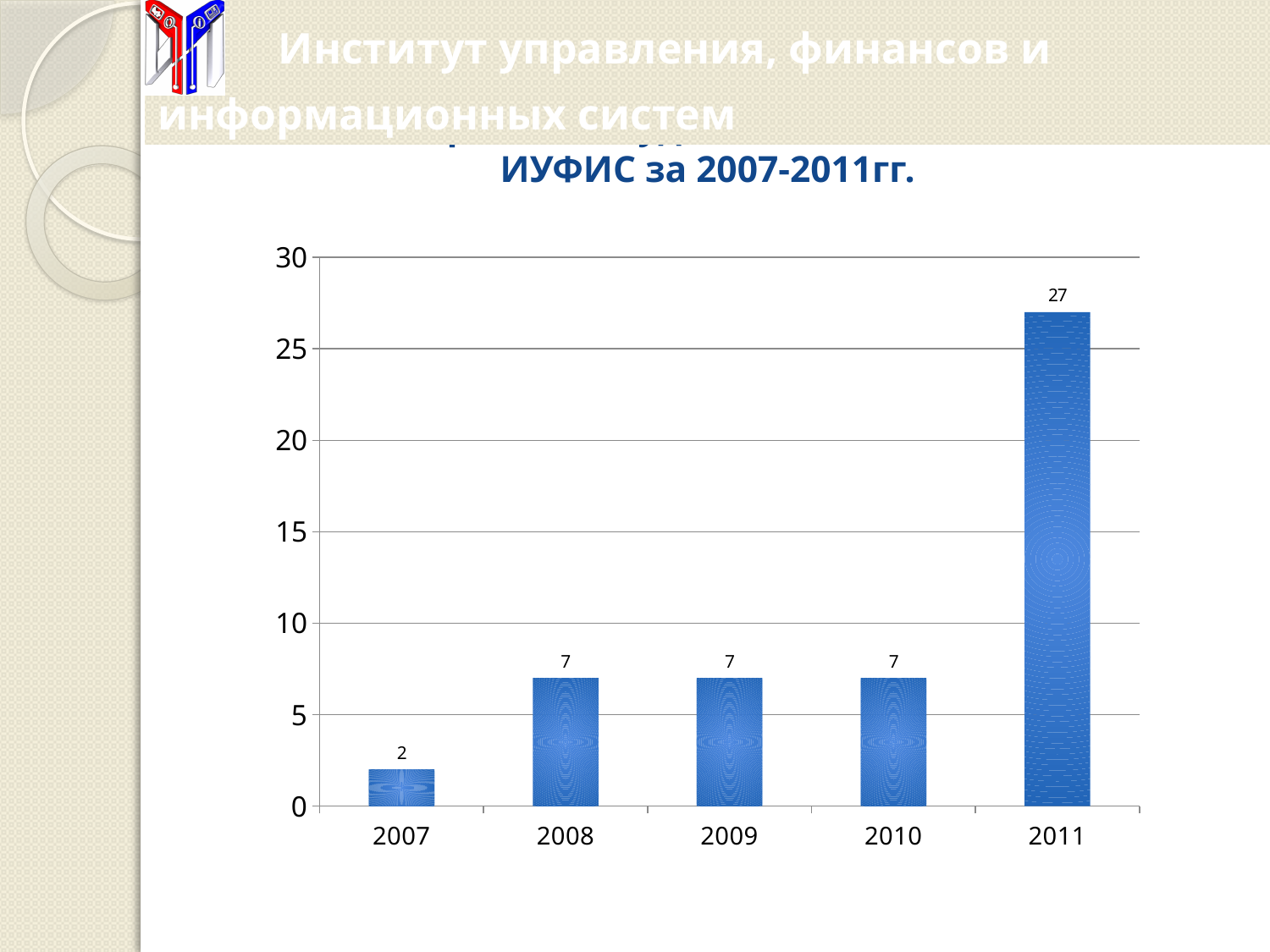
What is the value for 2009? 7 Do the values rise or fall from 2010 to 2011? rise How many years are shown on the x axis? 5 Which is larger, the value for 2007 or the value for 2008? 2008 What kind of chart is shown on the slide? bar chart Which year has the lowest value? 2007 What is the difference between the values for 2008 and 2007? 5 Which year has the highest value? 2011 What is the value for 2007? 2 Is the value for 2011 greater or less than 25? greater What is the value for 2011? 27 What is the difference between the values for 2011 and 2010? 20